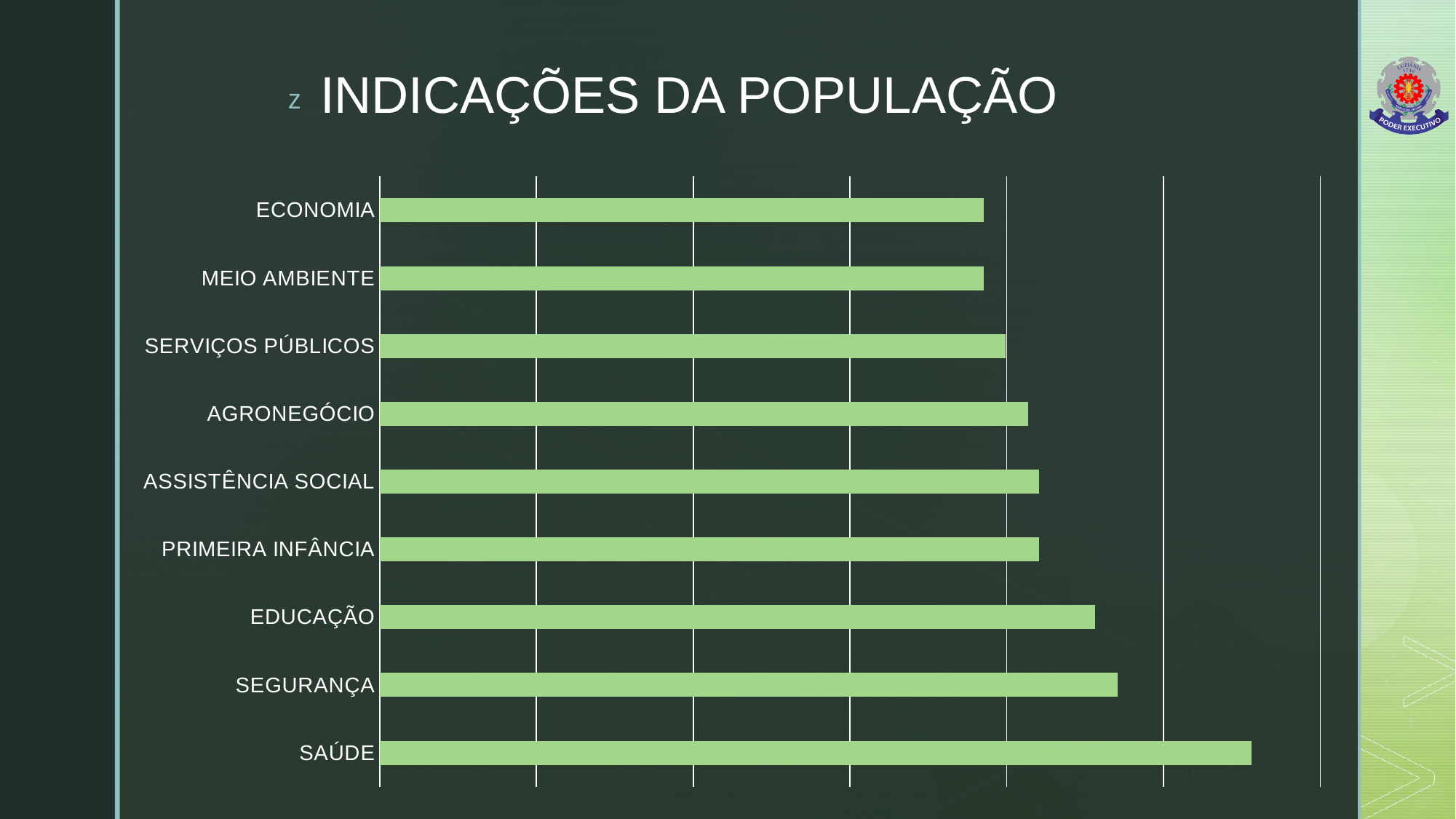
What type of chart is shown on the slide? Bar chart Which has the larger value, SAÚDE or EDUCAÇÃO? SAÚDE What colour are the bars in the chart? Green Which has the larger value, SEGURANÇA or AGRONEGÓCIO? SEGURANÇA Which category is listed at the top of the chart? ECONOMIA Which has the larger value, SAÚDE or MEIO AMBIENTE? SAÚDE Which category has the second-longest bar in the chart? SEGURANÇA Which category has the longest bar in the chart? SAÚDE How many categories are plotted in the chart? 9 What is the title of the chart on the slide? INDICAÇÕES DA POPULAÇÃO